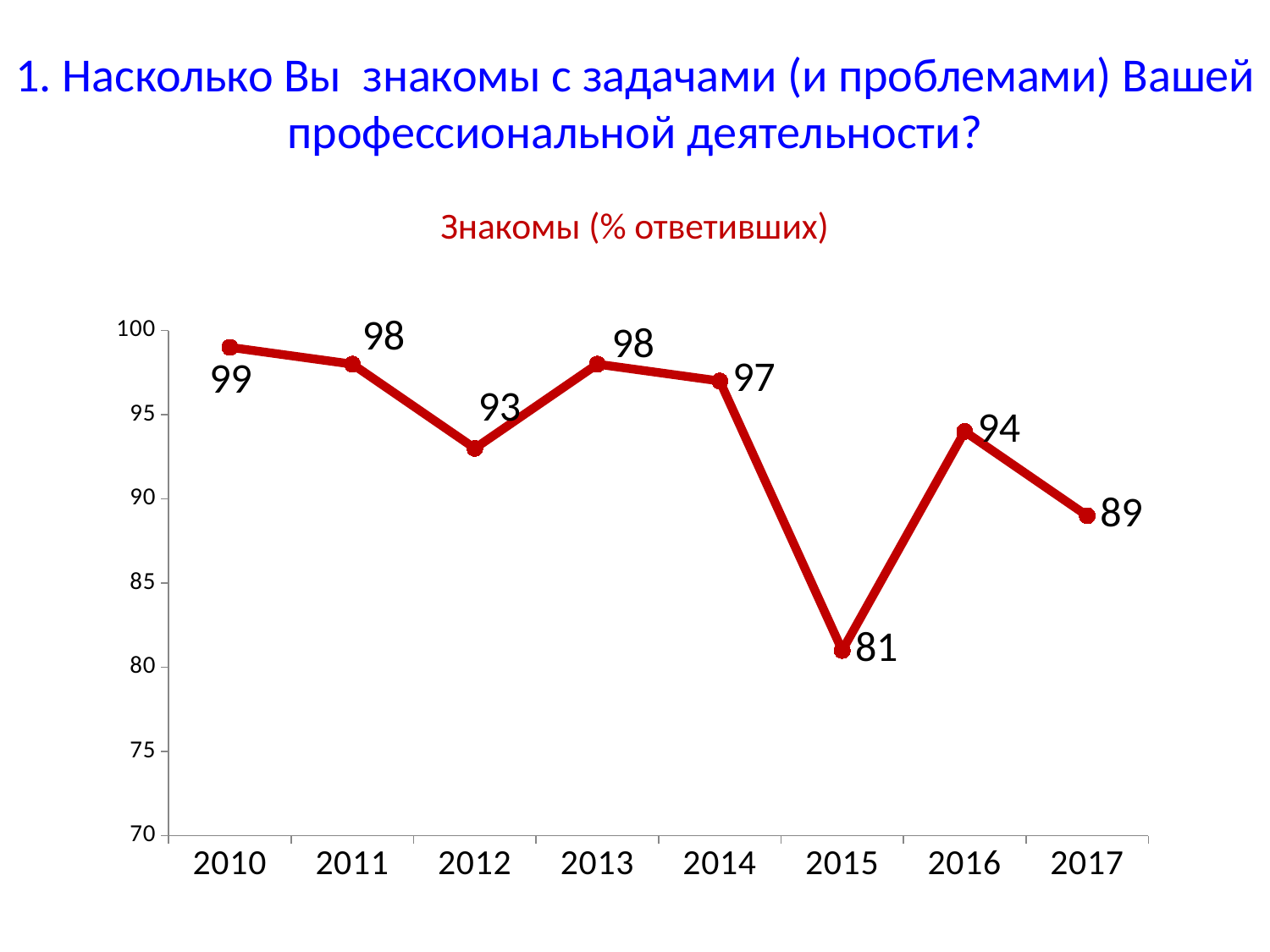
What is the difference between the values for 2014 and 2015? 16 Do the values rise or fall from 2015 to 2016? rise Which year has the lowest value? 2015 Which is larger, the value for 2016 or the value for 2017? 2016 Is the value for 2012 greater or less than 90? greater What is the value for 2017? 89 What is the value for 2015? 81 Which year has the highest value? 2010 What is the value for 2010? 99 What kind of chart is shown on the slide? line chart How many years are plotted on the chart? 8 What is the title of the chart? Знакомы (% ответивших)